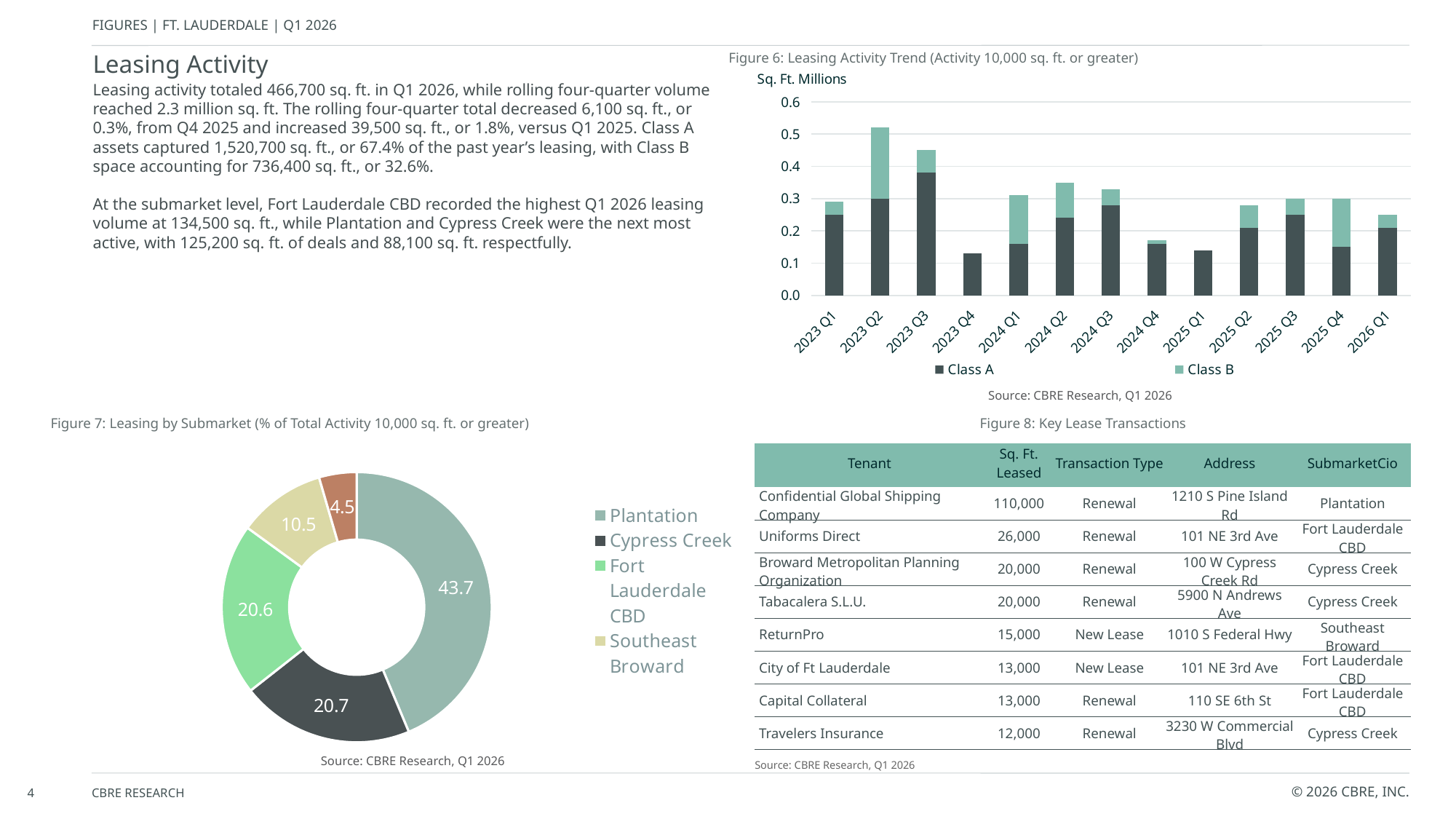
What kind of chart is Figure 6: Leasing Activity Trend? Stacked bar chart In Figure 6: Leasing Activity Trend, which quarter has the highest Class A value? 2023 Q3 In Figure 6: Leasing Activity Trend, how many series does the legend list? 2 In Figure 6: Leasing Activity Trend, is the total value for 2023 Q4 greater or less than 0.2? less In Figure 6: Leasing Activity Trend, how many quarters are shown on the x axis? 13 What kind of chart is Figure 7: Leasing by Submarket? Donut (pie) chart In Figure 7: Leasing by Submarket, how many submarkets are listed in the legend? 4 In Figure 6: Leasing Activity Trend, is the total value for 2023 Q3 greater or less than 0.4? greater In Figure 7: Leasing by Submarket, what is the value for Plantation? 43.7 In Figure 6: Leasing Activity Trend, which quarter has the highest total leasing activity? 2023 Q2 In Figure 7: Leasing by Submarket, what is the difference between the Plantation and Cypress Creek values? 23.0